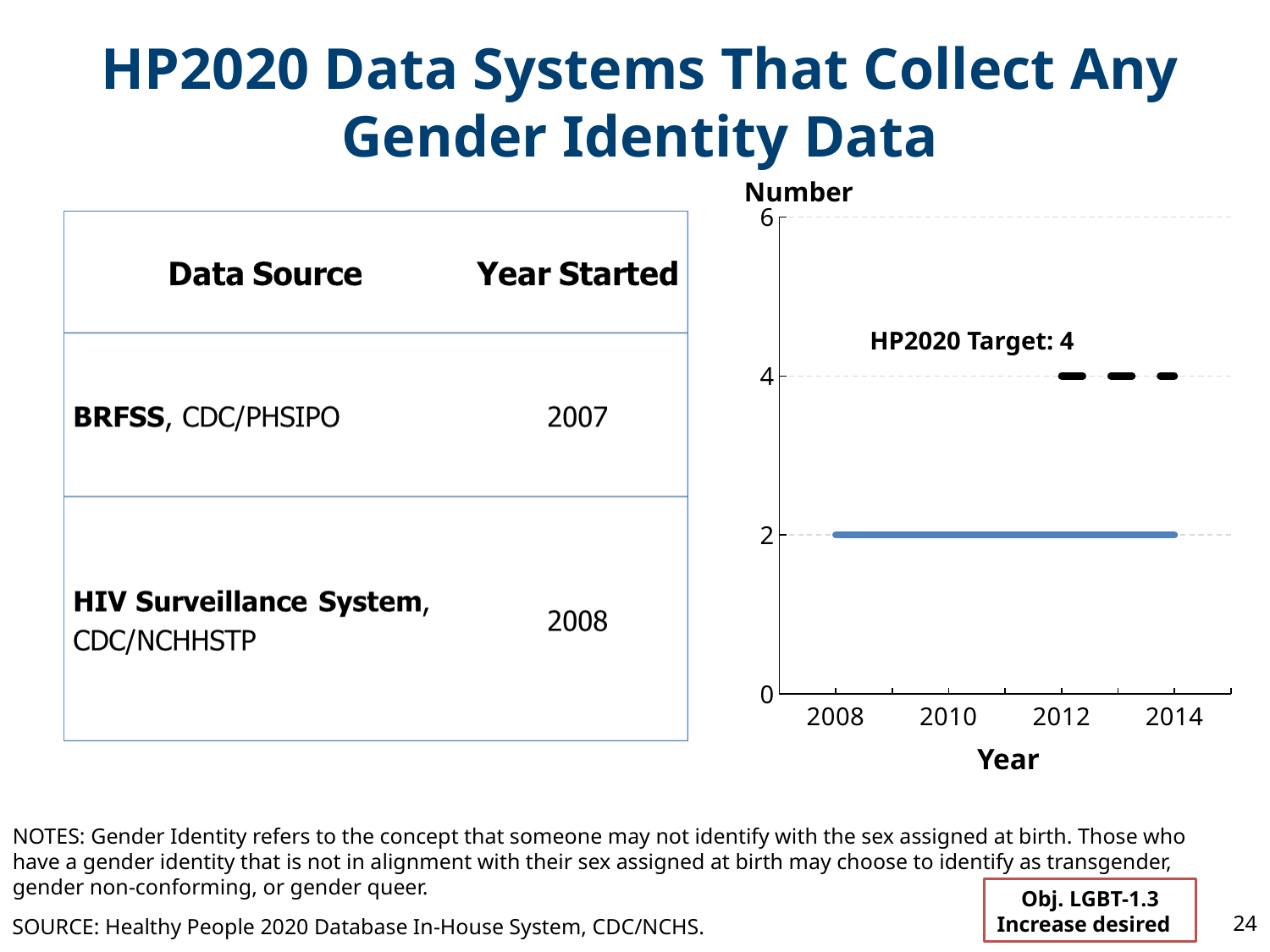
What is the highest value shown on the y axis of the chart? 6 Which is larger in 2013: the HP2020 target or the plotted number of data systems? the HP2020 target What is the number of data systems collecting gender identity data in 2014, according to the chart? 2 What kind of chart is shown on the slide? line chart Is the plotted value for 2010 greater or less than 4? less What is the HP2020 target value shown on the chart? 4 What is the difference between the HP2020 target and the plotted value in 2014? 2 What is the label on the y axis of the chart? Number Is the plotted value for 2012 greater or less than the HP2020 target of 4? less What is the number of data systems collecting gender identity data in 2008, according to the chart? 2 What is the label on the x axis of the chart? Year Does the plotted number of data systems rise, fall, or stay flat from 2008 to 2014? stays flat